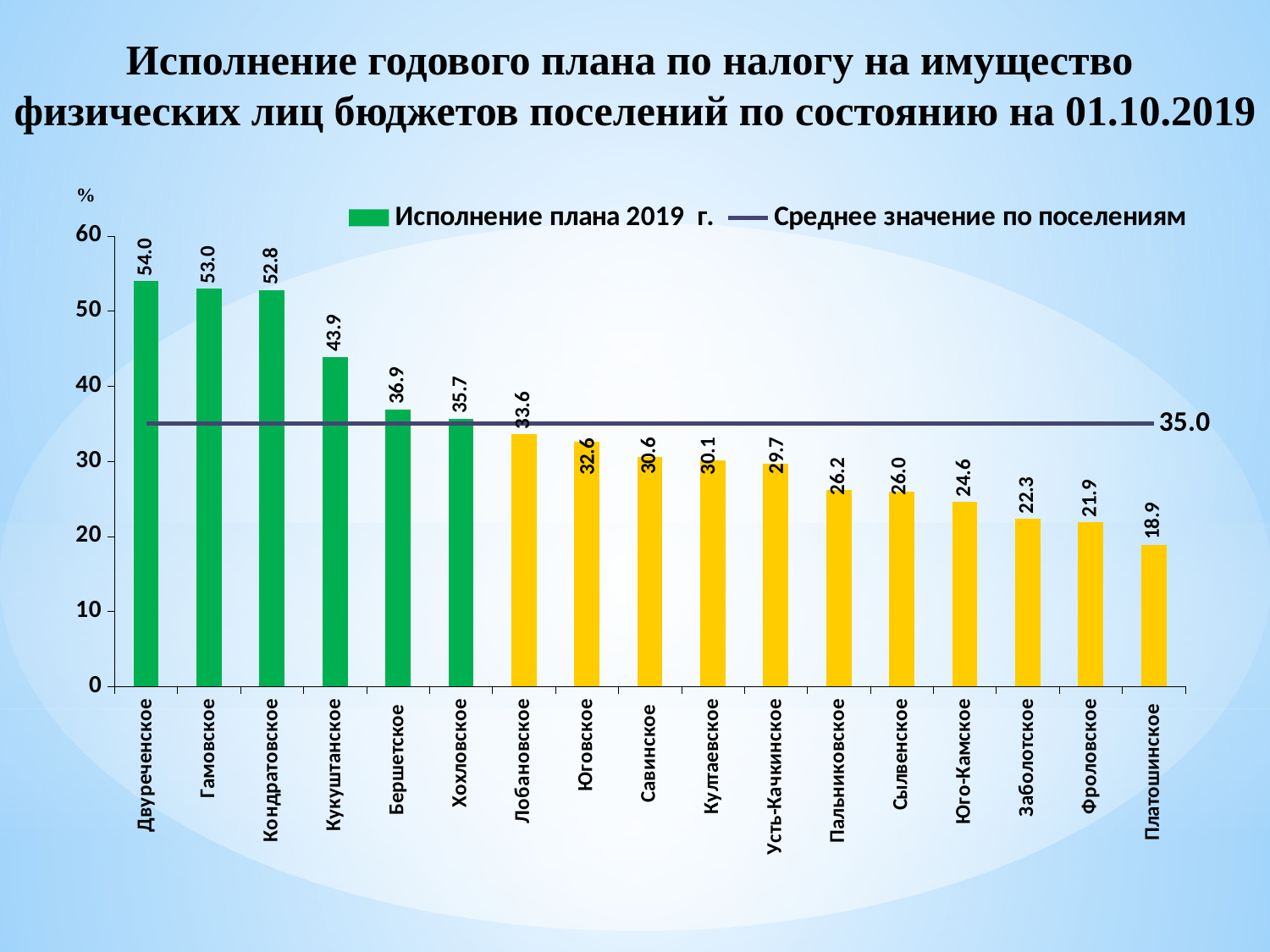
What is the value for Двуреченское? 54.0 Which settlement has the lowest value? Платошинское What is the value for Кукуштанское? 43.9 What is the value for Усть-Качкинское? 29.7 What kind of chart is shown on the slide? Bar chart How many settlements are shown on the x axis? 17 What is the value of the average line (Среднее значение по поселениям)? 35.0 What is the difference between the values for Гамовское and Кондратовское? 0.2 What is the difference between the values for Двуреченское and Платошинское? 35.1 Which settlement has the highest value? Двуреченское How many series does the legend list? 2 Which is larger, the value for Бершетское or the value for Лобановское? Бершетское